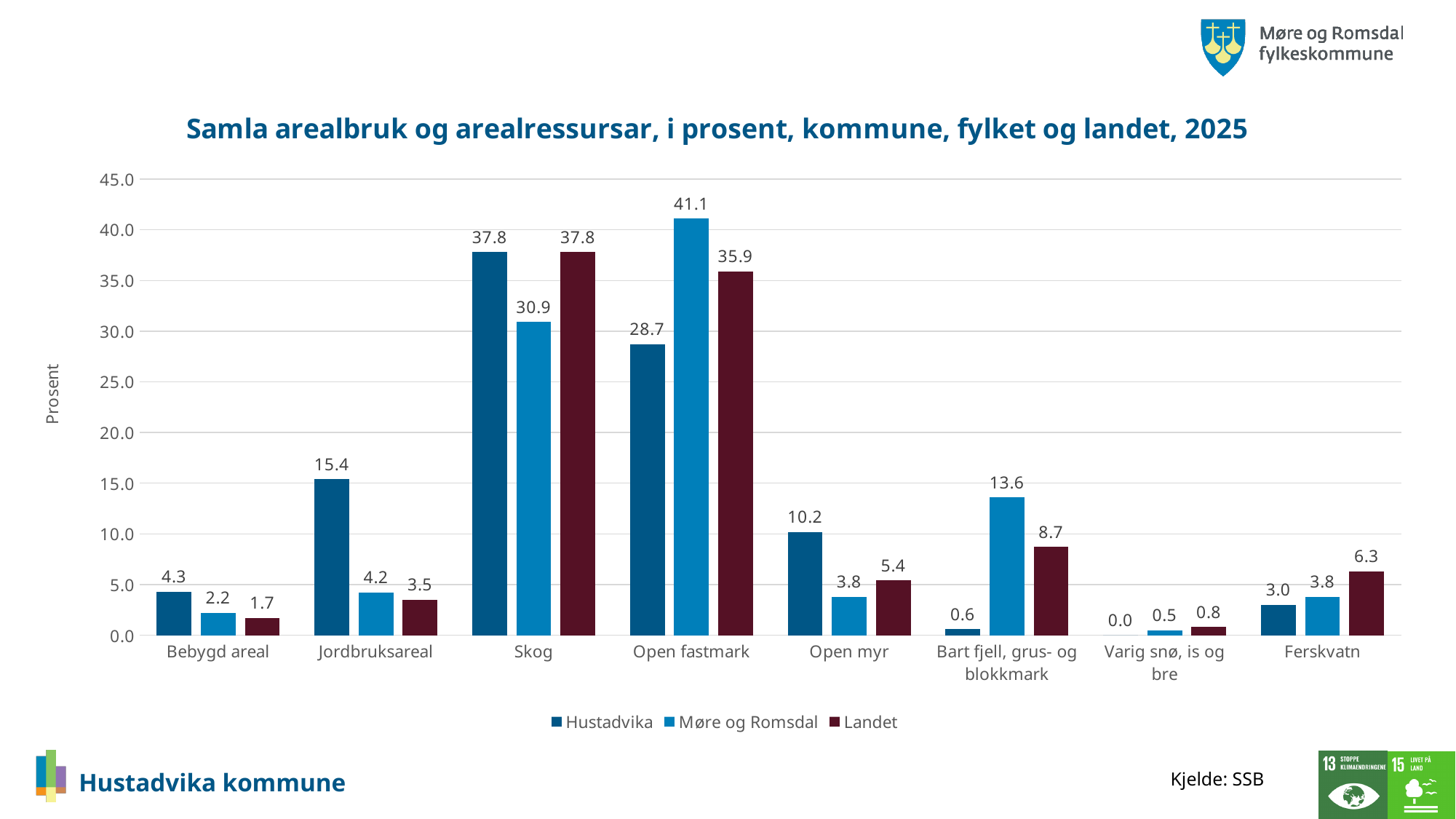
What is the difference between the Hustadvika and Landet values for Open myr? 4.8 What is the value for Møre og Romsdal in the Open fastmark category? 41.1 How many series does the legend list? 3 Which is larger for Bart fjell, grus- og blokkmark: Møre og Romsdal or Landet? Møre og Romsdal What kind of chart is shown on the slide? Bar chart What is the value for Hustadvika in the Jordbruksareal category? 15.4 Which category has the lowest value for Møre og Romsdal? Varig snø, is og bre What is the label on the y axis? Prosent What is the title of the chart? Samla arealbruk og arealressursar, i prosent, kommune, fylket og landet, 2025 Which category has the highest value for Hustadvika? Skog What is the value for Landet in the Ferskvatn category? 6.3 How many categories are shown on the x axis? 8